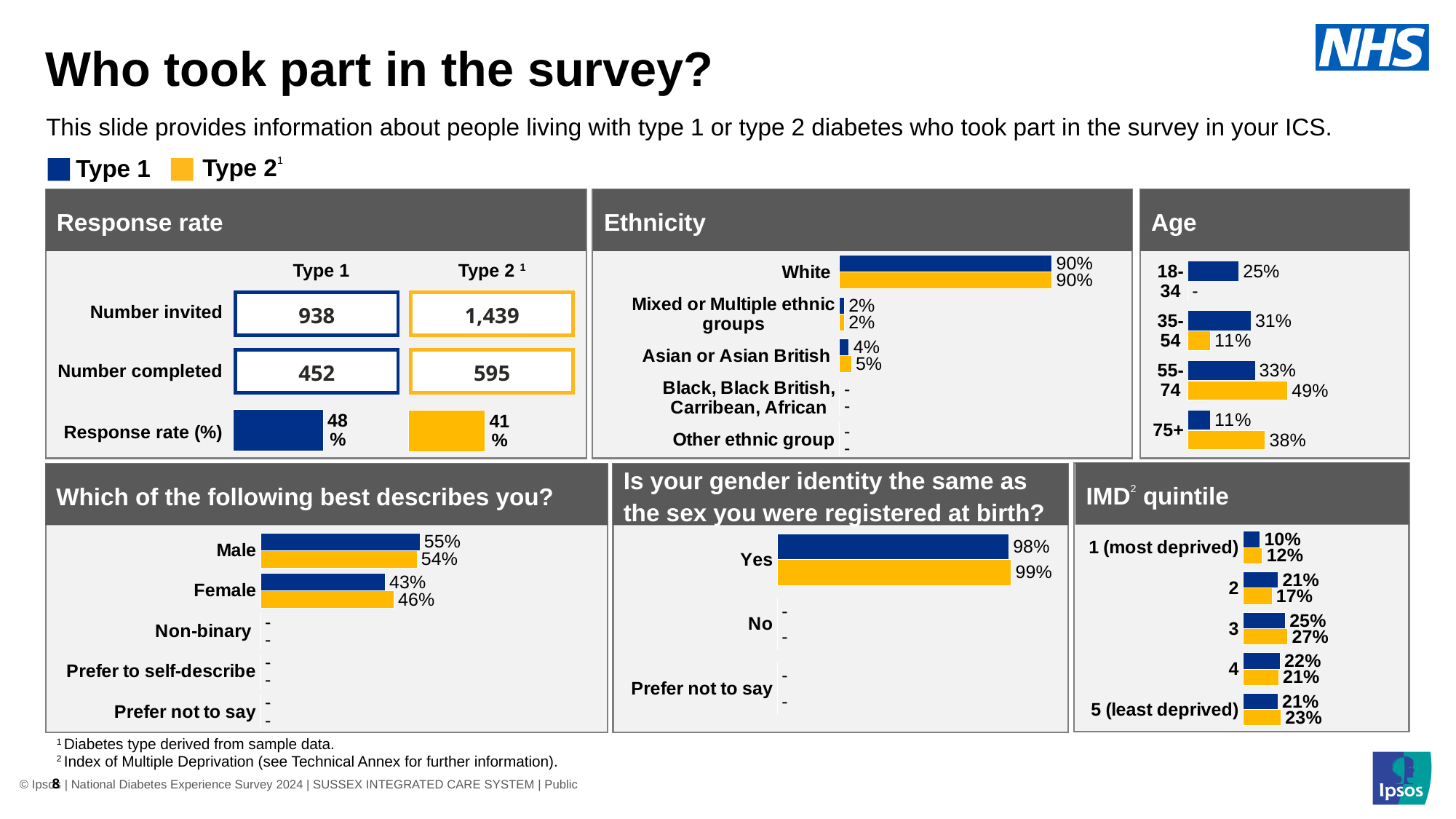
In the Age chart, which age group has the highest Type 1 value? 55-74 In the 'Which of the following best describes you?' chart, which is larger for Type 1: Male or Female? Male In the Ethnicity chart, what is the Type 1 value for White? 90% In the Response rate chart, what is the response rate (%) for Type 1? 48% In the Age chart, what is the Type 2 value for 55-74? 49% In the IMD quintile chart, what is the difference between the Type 1 and Type 2 values for quintile 2? 4% In the gender identity chart, what is the Type 2 value for Yes? 99% In the Age chart, what is the difference between the Type 2 values for 75+ and 35-54? 27% In the IMD quintile chart, which quintile has the lowest Type 1 value? 1 (most deprived) How many series does the legend at the top of the slide list? 2 In the Ethnicity chart, what is the Type 2 value for Asian or Asian British? 5% In the 'Which of the following best describes you?' chart, what is the Type 2 value for Female? 46%